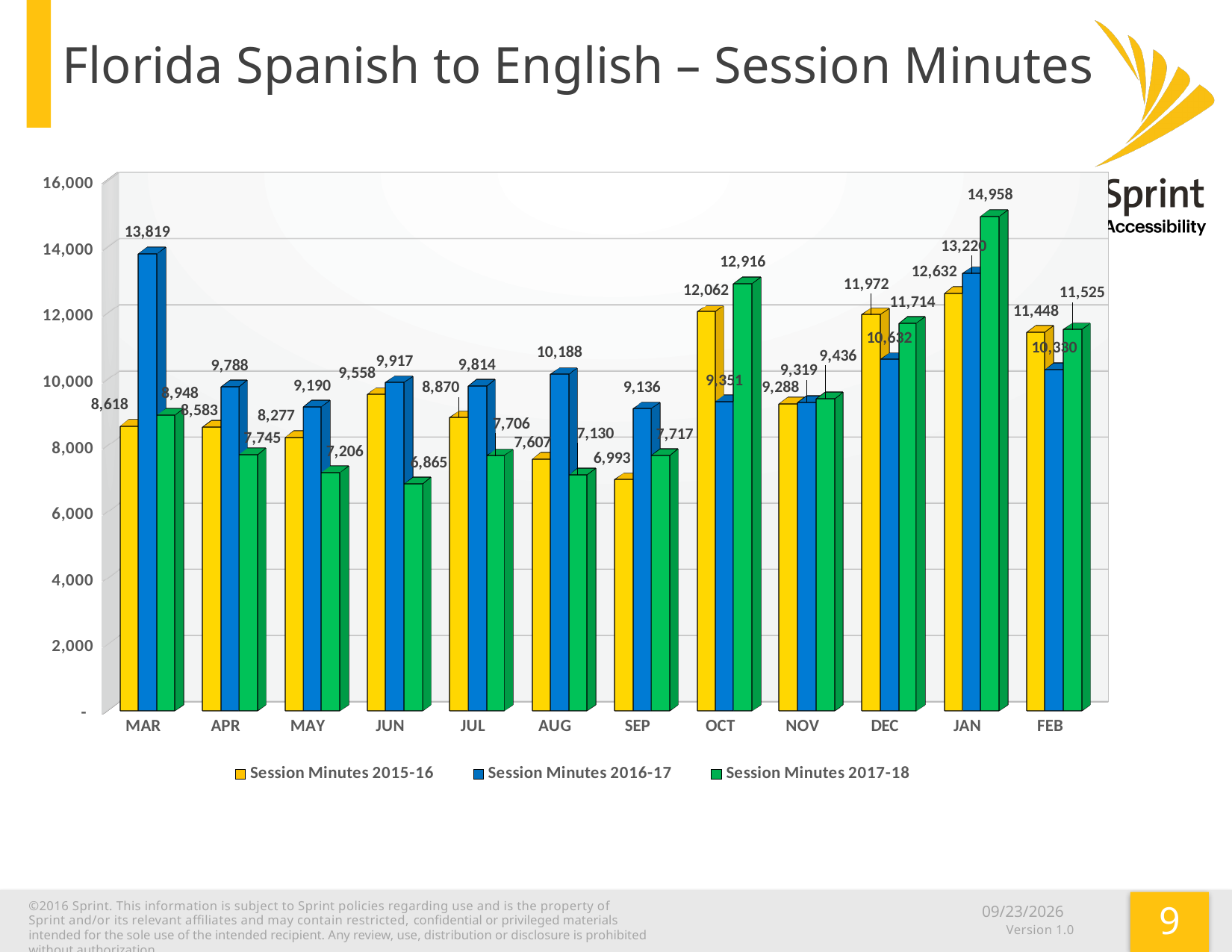
What is the difference between Session Minutes 2017-18 and Session Minutes 2016-17 for JAN? 1,738 What kind of chart is shown on the slide? bar chart What is the value of Session Minutes 2016-17 for MAR? 13,819 Is the value for Session Minutes 2016-17 in MAR greater or less than 12,000? greater How many series does the legend list? 3 Which month has the highest value for Session Minutes 2017-18? JAN Which month has the lowest value for Session Minutes 2017-18? JUN How many months are shown on the x axis? 12 Which month has the lowest value for Session Minutes 2015-16? SEP What is the value of Session Minutes 2017-18 for JAN? 14,958 For AUG, which is larger: Session Minutes 2015-16 or Session Minutes 2016-17? Session Minutes 2016-17 What is the value of Session Minutes 2015-16 for OCT? 12,062